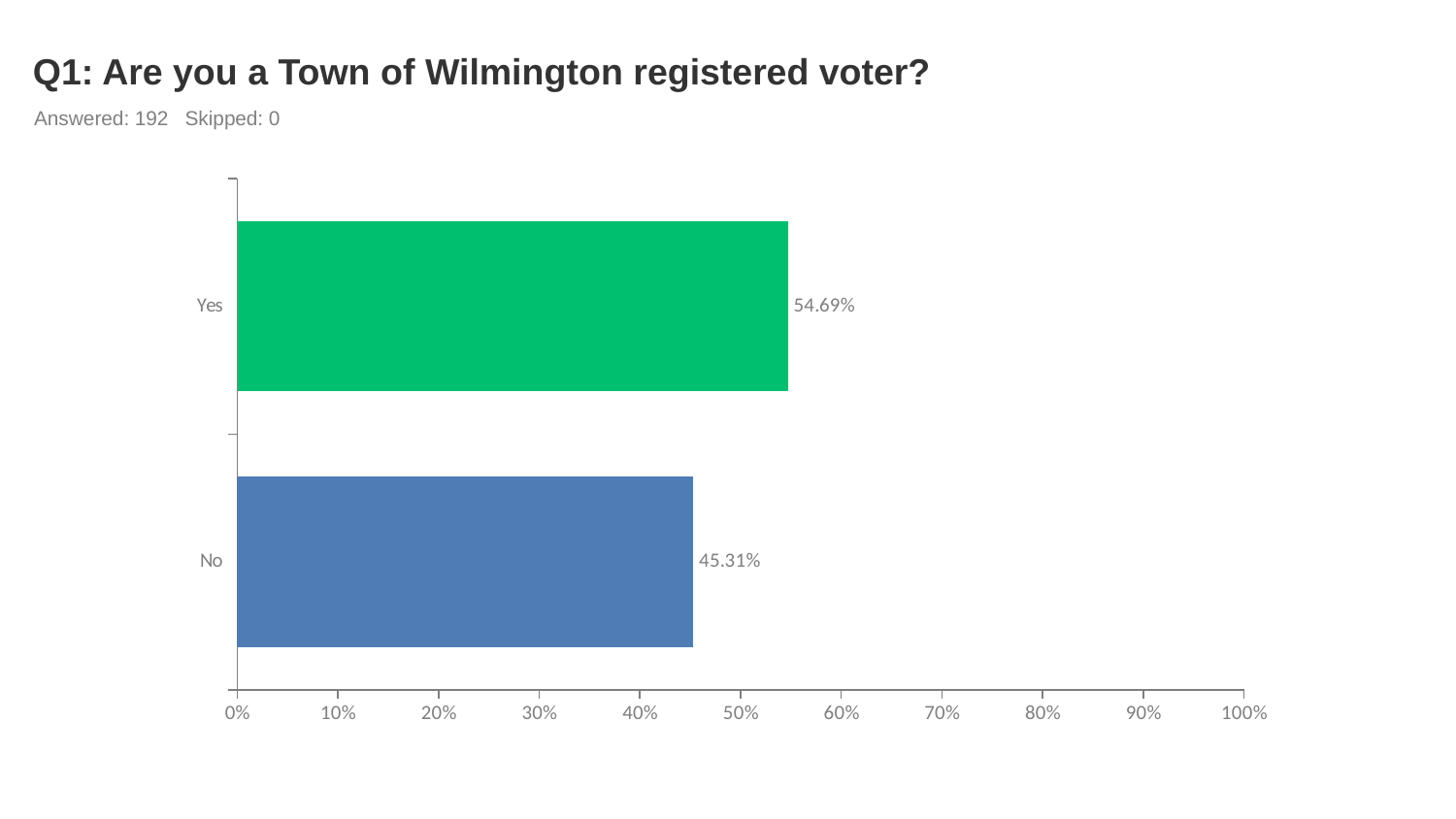
Is the value for Yes greater or less than 50%? greater What is the title of the chart? Q1: Are you a Town of Wilmington registered voter? How many respondents answered the question? 192 Is the value for No greater or less than 50%? less What percentage of respondents answered No? 45.31% Which is larger, the percentage for Yes or the percentage for No? Yes What kind of chart is shown on the slide? Bar chart Which response has the highest percentage? Yes What is the difference in percentage points between the Yes and No responses? 9.38% How many response categories are shown in the chart? 2 What percentage of respondents answered Yes? 54.69% Which response has the lowest percentage? No